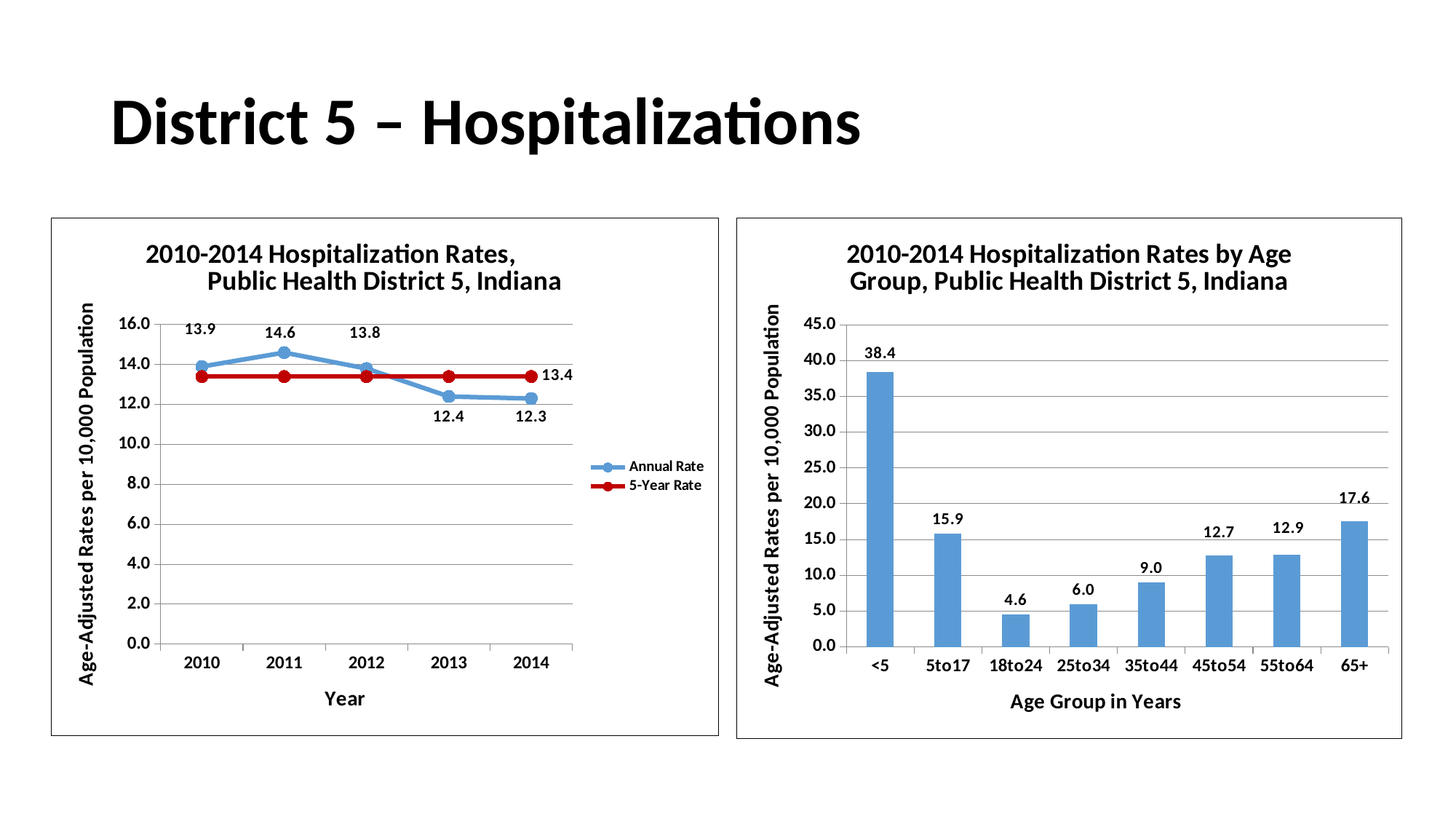
In the right chart (2010-2014 Hospitalization Rates by Age Group, Public Health District 5, Indiana), what is the difference between the rates for <5 and 65+? 20.8 In the right chart (2010-2014 Hospitalization Rates by Age Group, Public Health District 5, Indiana), which age group has the highest rate? <5 In the right chart (2010-2014 Hospitalization Rates by Age Group, Public Health District 5, Indiana), what is the rate for the 35to44 age group? 9.0 In the left chart (2010-2014 Hospitalization Rates, Public Health District 5, Indiana), how many series does the legend list? 2 In the left chart (2010-2014 Hospitalization Rates, Public Health District 5, Indiana), what is the Annual Rate for 2011? 14.6 In the left chart (2010-2014 Hospitalization Rates, Public Health District 5, Indiana), does the Annual Rate rise or fall from 2012 to 2014? fall In the left chart (2010-2014 Hospitalization Rates, Public Health District 5, Indiana), what is the 5-Year Rate? 13.4 What kind of chart is the right chart (2010-2014 Hospitalization Rates by Age Group, Public Health District 5, Indiana)? bar chart In the left chart (2010-2014 Hospitalization Rates, Public Health District 5, Indiana), which year has the lowest Annual Rate? 2014 In the right chart (2010-2014 Hospitalization Rates by Age Group, Public Health District 5, Indiana), which age group has the lowest rate? 18to24 In the left chart (2010-2014 Hospitalization Rates, Public Health District 5, Indiana), what is the difference between the Annual Rate in 2011 and in 2014? 2.3 In the right chart (2010-2014 Hospitalization Rates by Age Group, Public Health District 5, Indiana), how many age groups are shown? 8